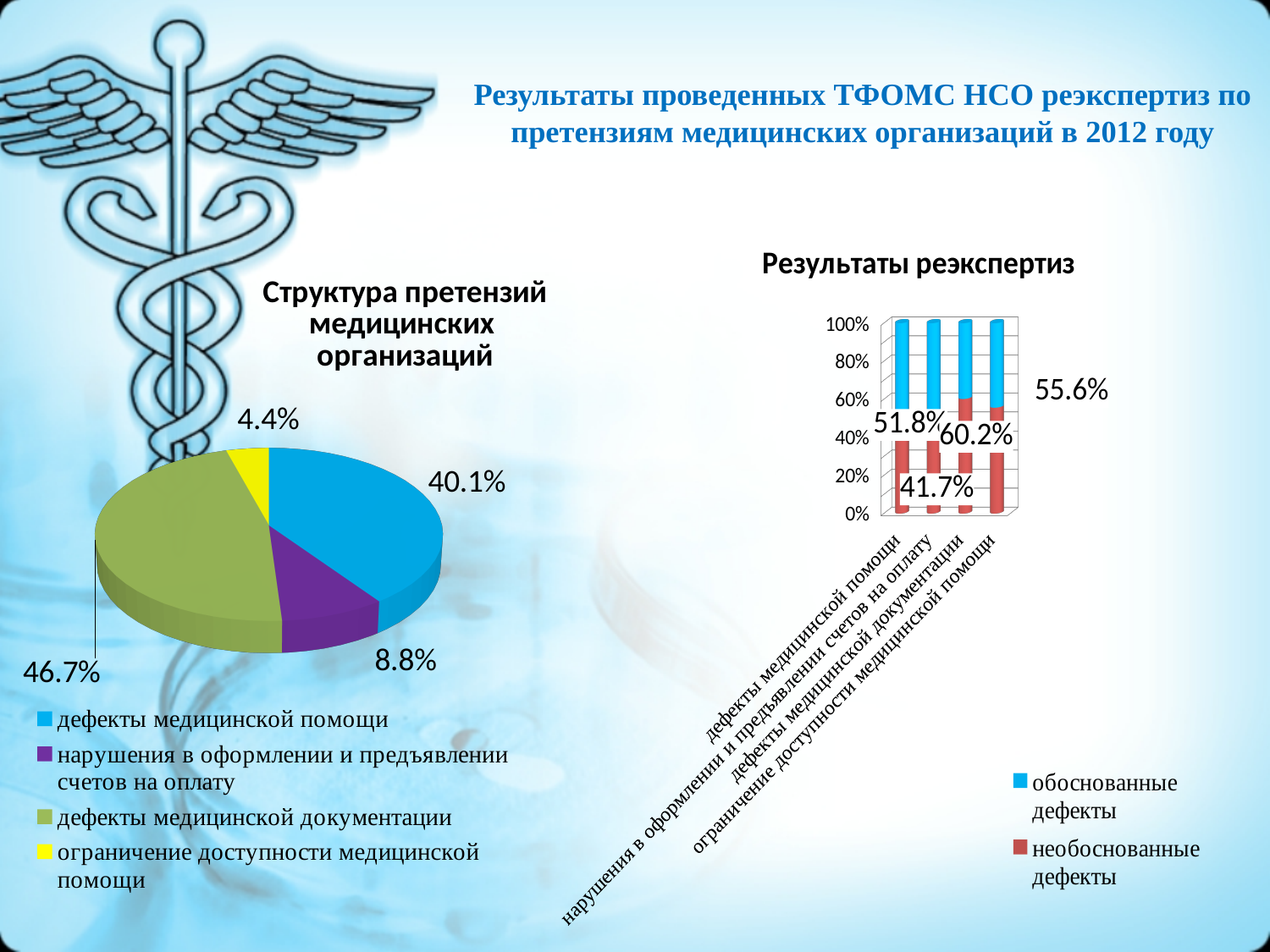
In the chart 'Результаты реэкспертиз', which category has the lowest value for 'необоснованные дефекты'? нарушения в оформлении и предъявлении счетов на оплату In the pie chart 'Структура претензий медицинских организаций', which category has the smallest slice? ограничение доступности медицинской помощи How many categories are shown on the x axis of the chart 'Результаты реэкспертиз'? 4 In the chart 'Результаты реэкспертиз', what is the value of 'необоснованные дефекты' for 'дефекты медицинской документации'? 60.2% In the pie chart 'Структура претензий медицинских организаций', what is the difference between the shares for 'дефекты медицинской документации' and 'дефекты медицинской помощи'? 6.6 percentage points How many series does the legend of the chart 'Результаты реэкспертиз' list? 2 In the pie chart 'Структура претензий медицинских организаций', which is larger: 'нарушения в оформлении и предъявлении счетов на оплату' or 'ограничение доступности медицинской помощи'? нарушения в оформлении и предъявлении счетов на оплату What kind of chart is 'Структура претензий медицинских организаций'? Pie chart In the pie chart 'Структура претензий медицинских организаций', which category has the largest slice? дефекты медицинской документации In the pie chart 'Структура претензий медицинских организаций', what share is shown for 'дефекты медицинской помощи'? 40.1% How many slices does the pie chart 'Структура претензий медицинских организаций' have? 4 What kind of chart is 'Результаты реэкспертиз'? Stacked bar chart